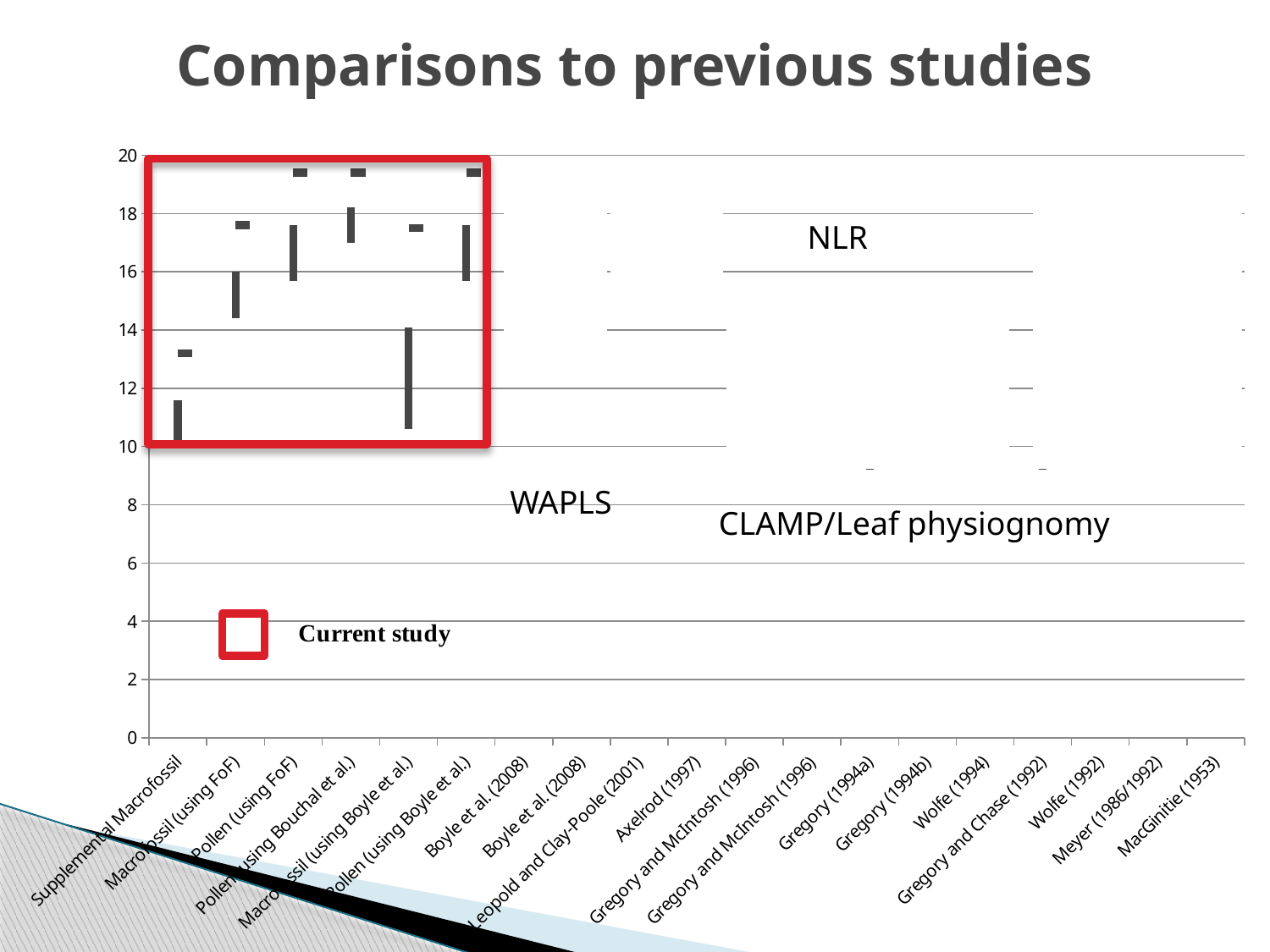
How many categories are listed along the x axis of the chart? 19 Is the bar for Pollen (using FoF) greater or less than 14? greater How many categories are enclosed by the red box labelled 'Current study'? 6 Which category in the red box has the lowest bar? Supplemental Macrofossil What is the first category on the x axis of the chart? Supplemental Macrofossil What kind of chart is shown on the slide? bar chart Is the bottom of the bar for Macrofossil (using Boyle et al.) greater or less than 12? less Which has the lower bar, Supplemental Macrofossil or Macrofossil (using FoF)? Supplemental Macrofossil What is the title of the chart? Comparisons to previous studies What is the highest value shown on the y axis of the chart? 20